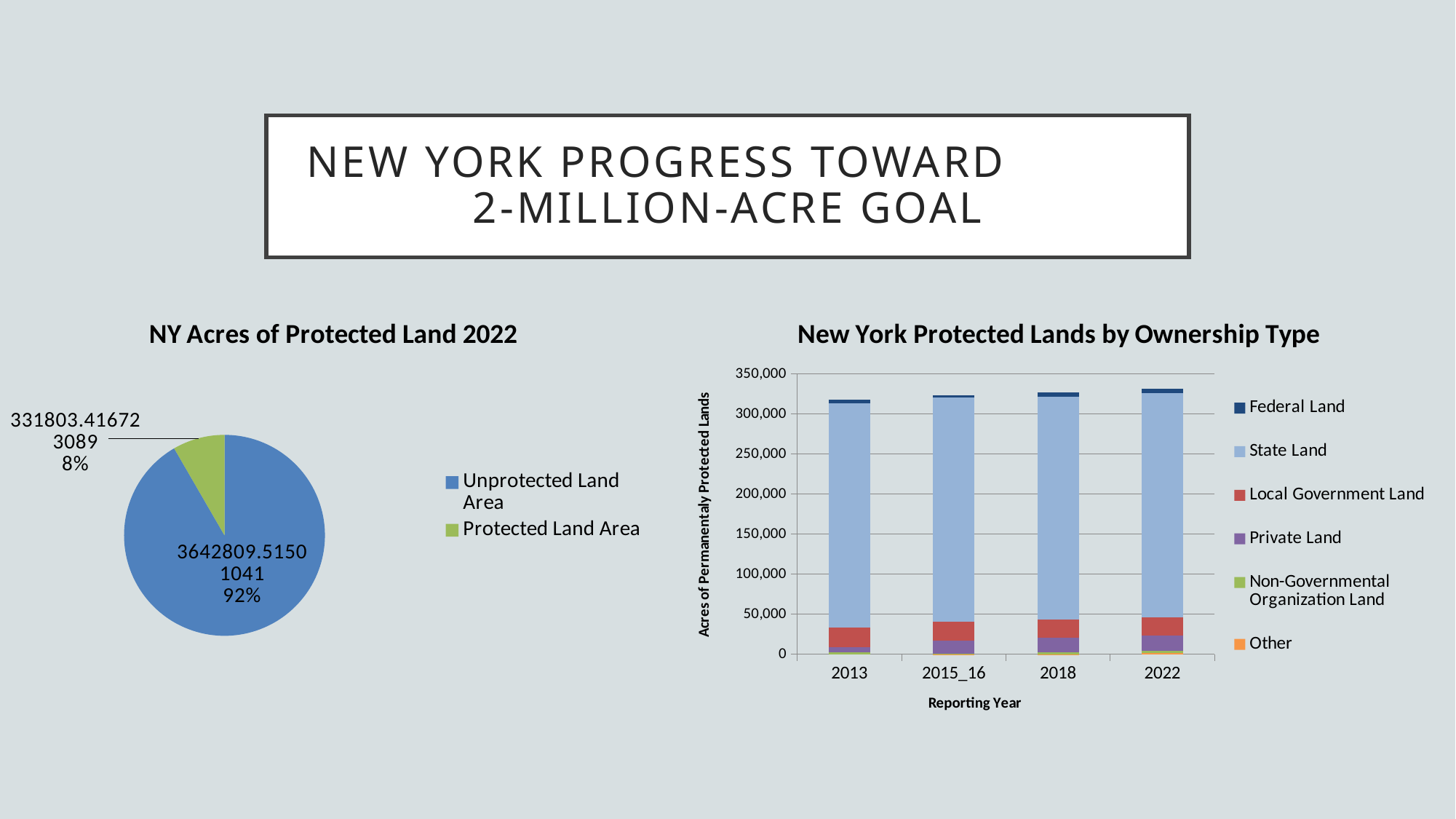
How many slices does the 'NY Acres of Protected Land 2022' pie chart have? 2 In the 'NY Acres of Protected Land 2022' pie chart, which slice is larger: Unprotected Land Area or Protected Land Area? Unprotected Land Area In 'New York Protected Lands by Ownership Type', is the total for 2022 greater or less than 350,000? less What kind of chart is 'NY Acres of Protected Land 2022'? pie chart How many series does the legend of 'New York Protected Lands by Ownership Type' list? 6 In 'New York Protected Lands by Ownership Type', which ownership type makes up the largest part of each bar? State Land In the 'NY Acres of Protected Land 2022' pie chart, what share is Unprotected Land Area? 92% In the 'NY Acres of Protected Land 2022' pie chart, what share is Protected Land Area? 8% In 'New York Protected Lands by Ownership Type', is the total for 2013 greater or less than 300,000? greater What kind of chart is 'New York Protected Lands by Ownership Type'? stacked bar chart How many reporting years are shown on the x axis of 'New York Protected Lands by Ownership Type'? 4 In 'New York Protected Lands by Ownership Type', do the total protected acres rise or fall from 2013 to 2022? rise